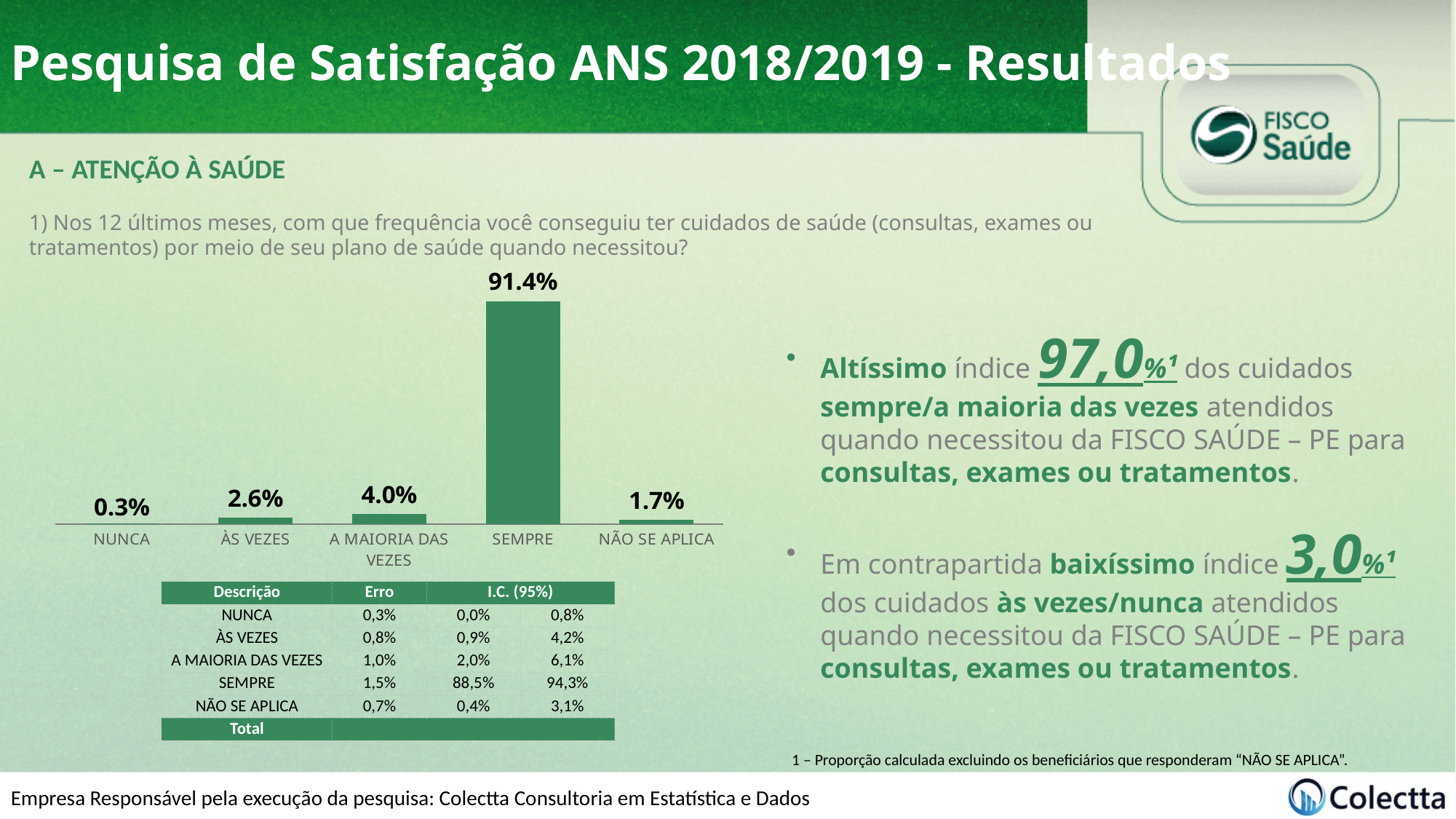
Which is larger, the value for ÀS VEZES or the value for A MAIORIA DAS VEZES? A MAIORIA DAS VEZES Which category has the highest value? SEMPRE What is the difference between the values for SEMPRE and A MAIORIA DAS VEZES? 87.4% What kind of chart is shown on the slide? Bar chart What is the value for ÀS VEZES? 2.6% What is the value for A MAIORIA DAS VEZES? 4.0% What is the value for NUNCA? 0.3% Which category has the lowest value? NUNCA What is the value for NÃO SE APLICA? 1.7% How many categories are shown in the chart? 5 What is the value for SEMPRE? 91.4% What is the difference between the values for ÀS VEZES and NÃO SE APLICA? 0.9%